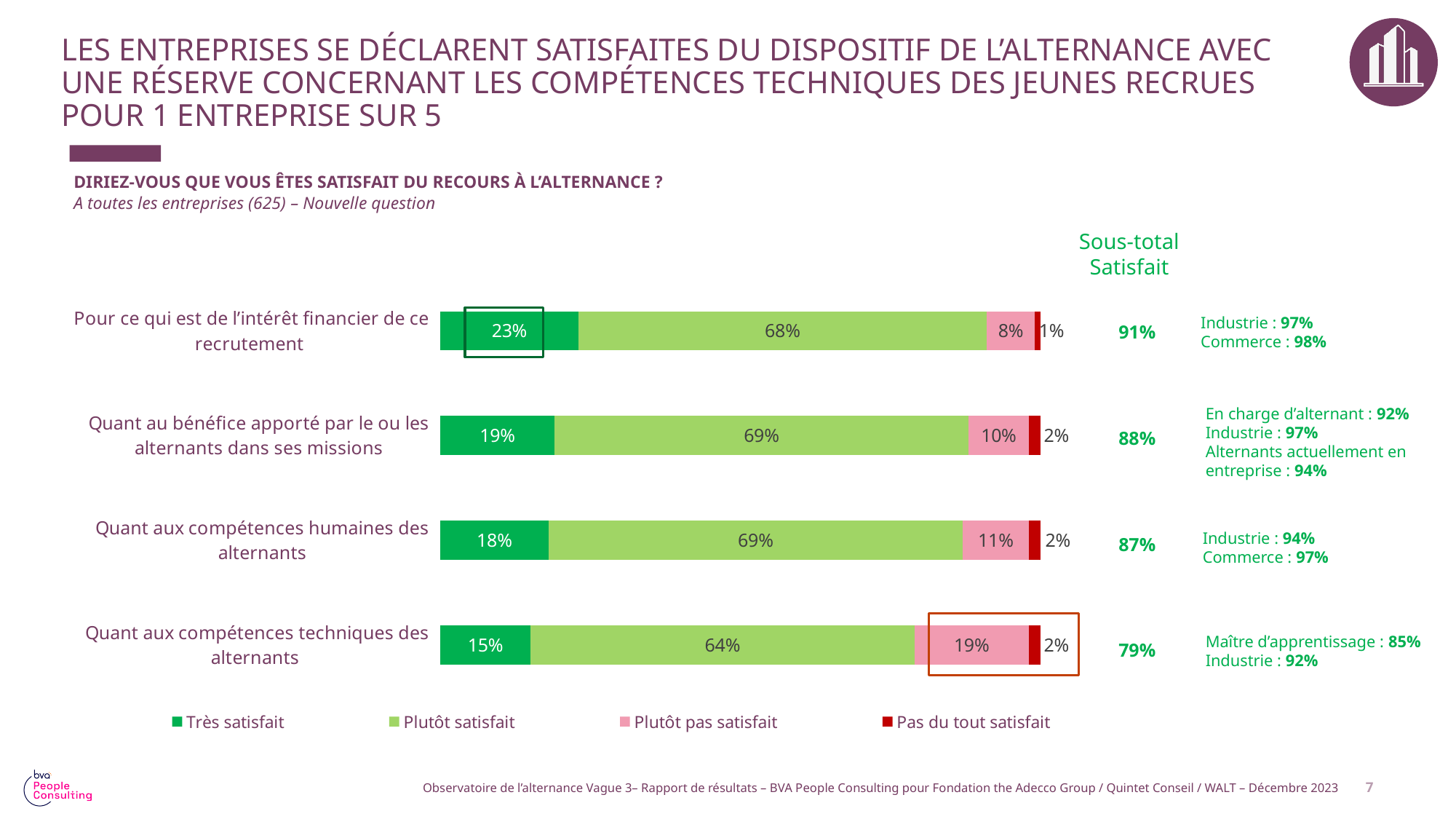
How many series does the legend list? 4 Which category has the highest 'Très satisfait' share? Pour ce qui est de l'intérêt financier de ce recrutement What is the combined total of 'Très satisfait' and 'Plutôt satisfait' for 'Quant au bénéfice apporté par le ou les alternants dans ses missions'? 88% Which legend entry is shown in dark red? Pas du tout satisfait Which category has the lowest 'Sous-total Satisfait'? Quant aux compétences techniques des alternants What percentage of companies are 'Très satisfait' regarding 'Pour ce qui est de l'intérêt financier de ce recrutement'? 23% Which is larger: the 'Plutôt satisfait' value for 'Quant au bénéfice apporté par le ou les alternants dans ses missions' or for 'Quant aux compétences techniques des alternants'? Quant au bénéfice apporté par le ou les alternants dans ses missions What is the 'Plutôt pas satisfait' value for 'Quant aux compétences techniques des alternants'? 19% How many categories (rows) are shown in the chart? 4 What is the 'Sous-total Satisfait' for 'Quant aux compétences humaines des alternants'? 87% What is the difference between the 'Plutôt pas satisfait' values for 'Quant aux compétences techniques des alternants' and 'Pour ce qui est de l'intérêt financier de ce recrutement'? 11% What kind of chart is shown on the slide? Stacked bar chart